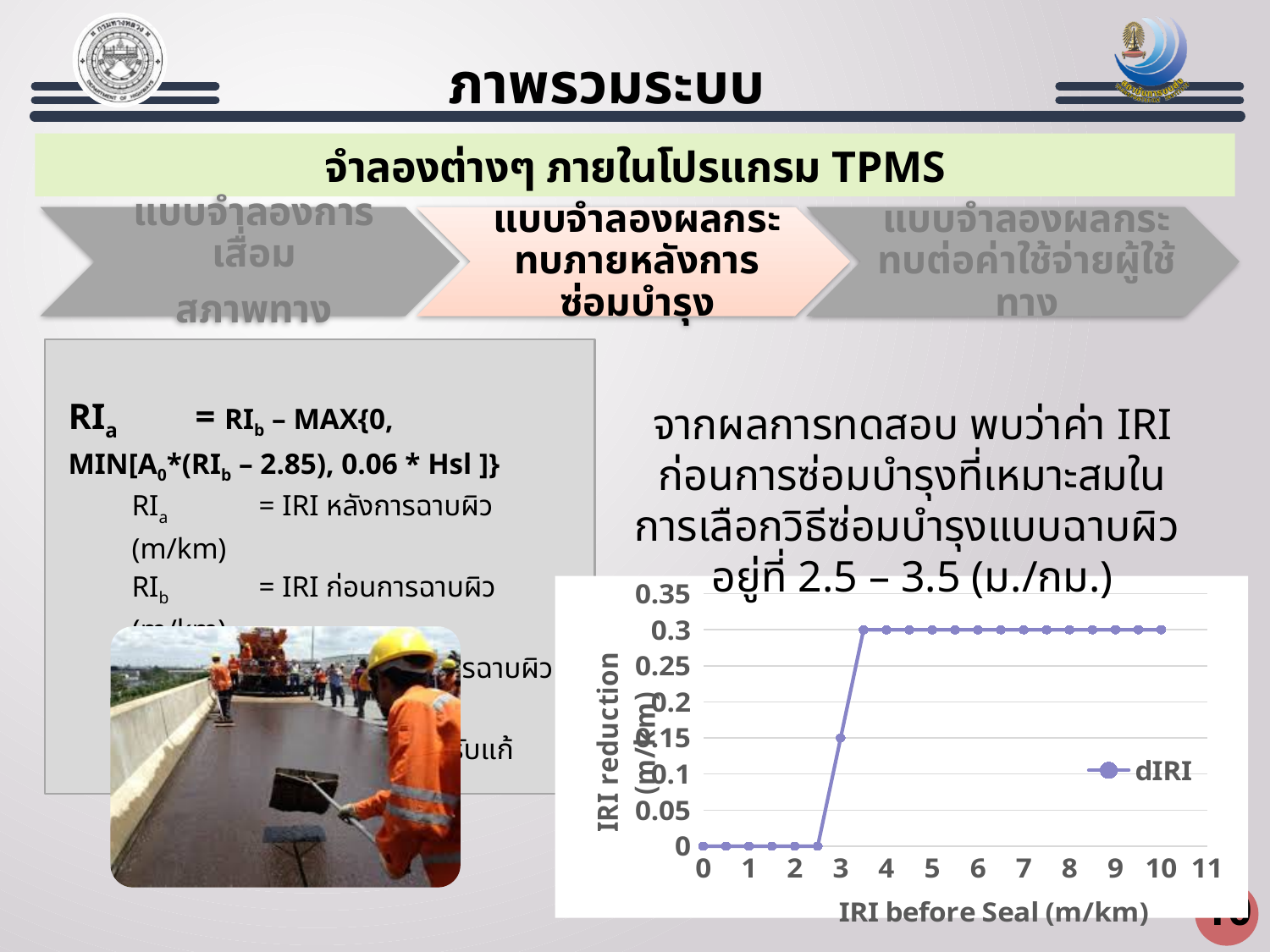
Which has a larger IRI reduction value: IRI before Seal of 1 or IRI before Seal of 4? IRI before Seal of 4 How many series does the chart legend list? 1 What kind of chart is shown on the slide? line chart What is the IRI reduction value when IRI before Seal is 5? 0.3 What is the title of the x axis of the chart? IRI before Seal (m/km) What is the IRI reduction value when IRI before Seal is 3? 0.15 What is the IRI reduction value when IRI before Seal is 10? 0.3 What is the IRI reduction value when IRI before Seal is 2? 0 What is the name of the series shown in the chart legend? dIRI Is the IRI reduction value at IRI before Seal of 8 greater or less than 0.2? greater What is the highest IRI reduction value plotted on the chart? 0.3 Do the IRI reduction values rise or fall as IRI before Seal increases from 2 to 4? rise